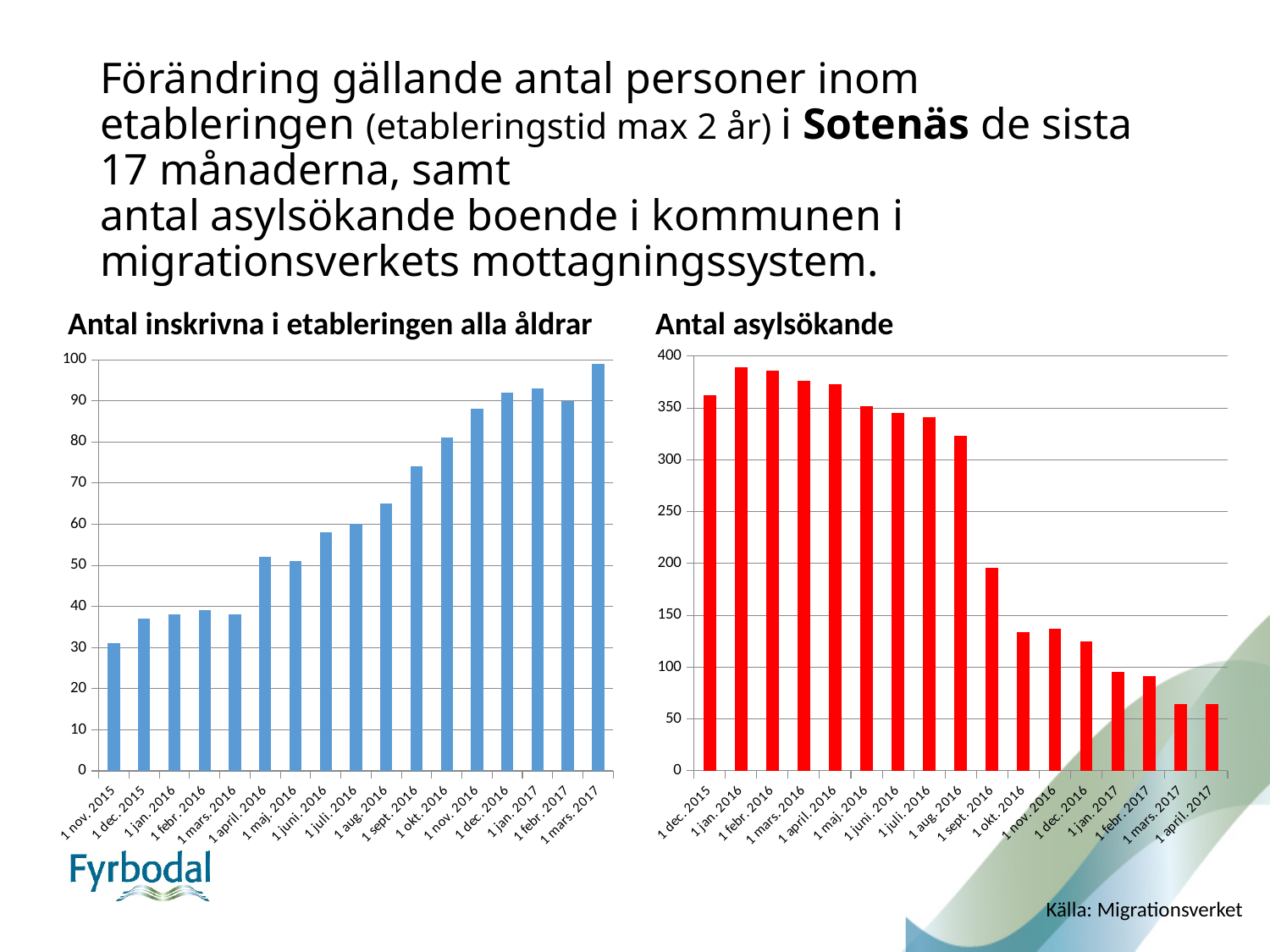
What kind of chart is the 'Antal inskrivna i etableringen alla åldrar' chart on the left? bar chart In the 'Antal inskrivna i etableringen alla åldrar' chart, do the values generally rise or fall from 1 nov. 2015 to 1 mars 2017? rise In the 'Antal inskrivna i etableringen alla åldrar' chart, is the value for 1 mars 2017 greater or less than 90? greater In the 'Antal inskrivna i etableringen alla åldrar' chart, is the value for 1 nov. 2015 greater or less than 40? less How many bars are plotted in the 'Antal asylsökande' chart on the right? 17 In the 'Antal asylsökande' chart, which is larger, the value for 1 aug. 2016 or the value for 1 sept. 2016? 1 aug. 2016 What colour are the bars in the 'Antal asylsökande' chart? red In the 'Antal inskrivna i etableringen alla åldrar' chart, which date has the highest bar? 1 mars 2017 In the 'Antal asylsökande' chart, is the value for 1 dec. 2015 greater or less than 350? greater In the 'Antal inskrivna i etableringen alla åldrar' chart, which date has the lowest bar? 1 nov. 2015 In the 'Antal asylsökande' chart, do the values generally rise or fall from left to right along the x axis? fall